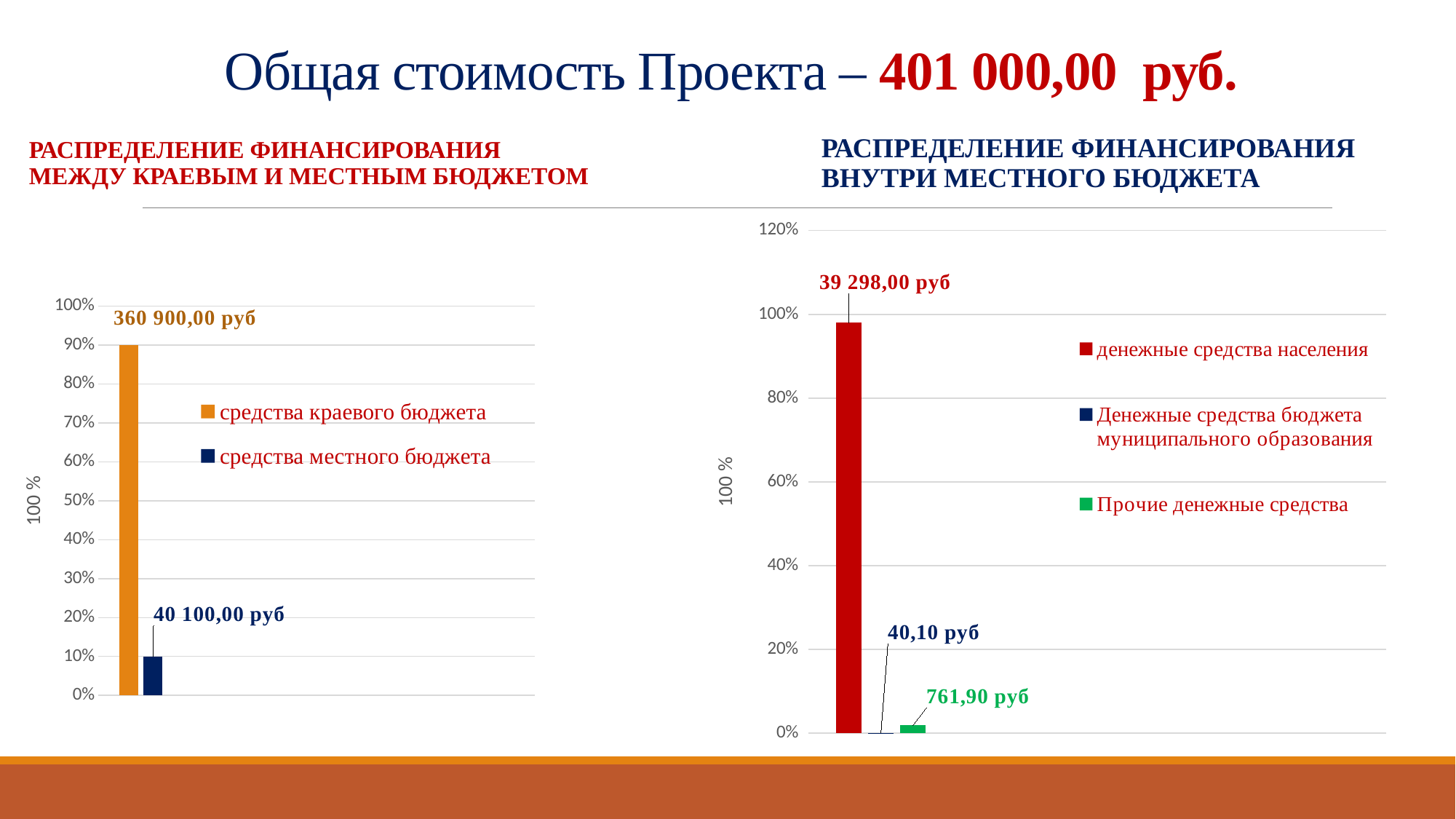
In the left chart, is the bar for средства краевого бюджета greater or less than 80%? greater What type of chart is the right chart? bar chart In the right chart, what value is labelled for Прочие денежные средства? 761,90 руб In the right chart, what is the difference between Прочие денежные средства and Денежные средства бюджета муниципального образования? 721,80 руб In the right chart, how many series does the legend list? 3 In the left chart (РАСПРЕДЕЛЕНИЕ ФИНАНСИРОВАНИЯ МЕЖДУ КРАЕВЫМ И МЕСТНЫМ БЮДЖЕТОМ), what value is labelled for средства краевого бюджета? 360 900,00 руб In the left chart, what value is labelled for средства местного бюджета? 40 100,00 руб In the right chart, which series has the smallest value? Денежные средства бюджета муниципального образования In the right chart (РАСПРЕДЕЛЕНИЕ ФИНАНСИРОВАНИЯ ВНУТРИ МЕСТНОГО БЮДЖЕТА), what value is labelled for денежные средства населения? 39 298,00 руб In the left chart, what is the difference between средства краевого бюджета and средства местного бюджета? 320 800,00 руб In the left chart, how many series does the legend list? 2 In the left chart, which series has the larger value? средства краевого бюджета